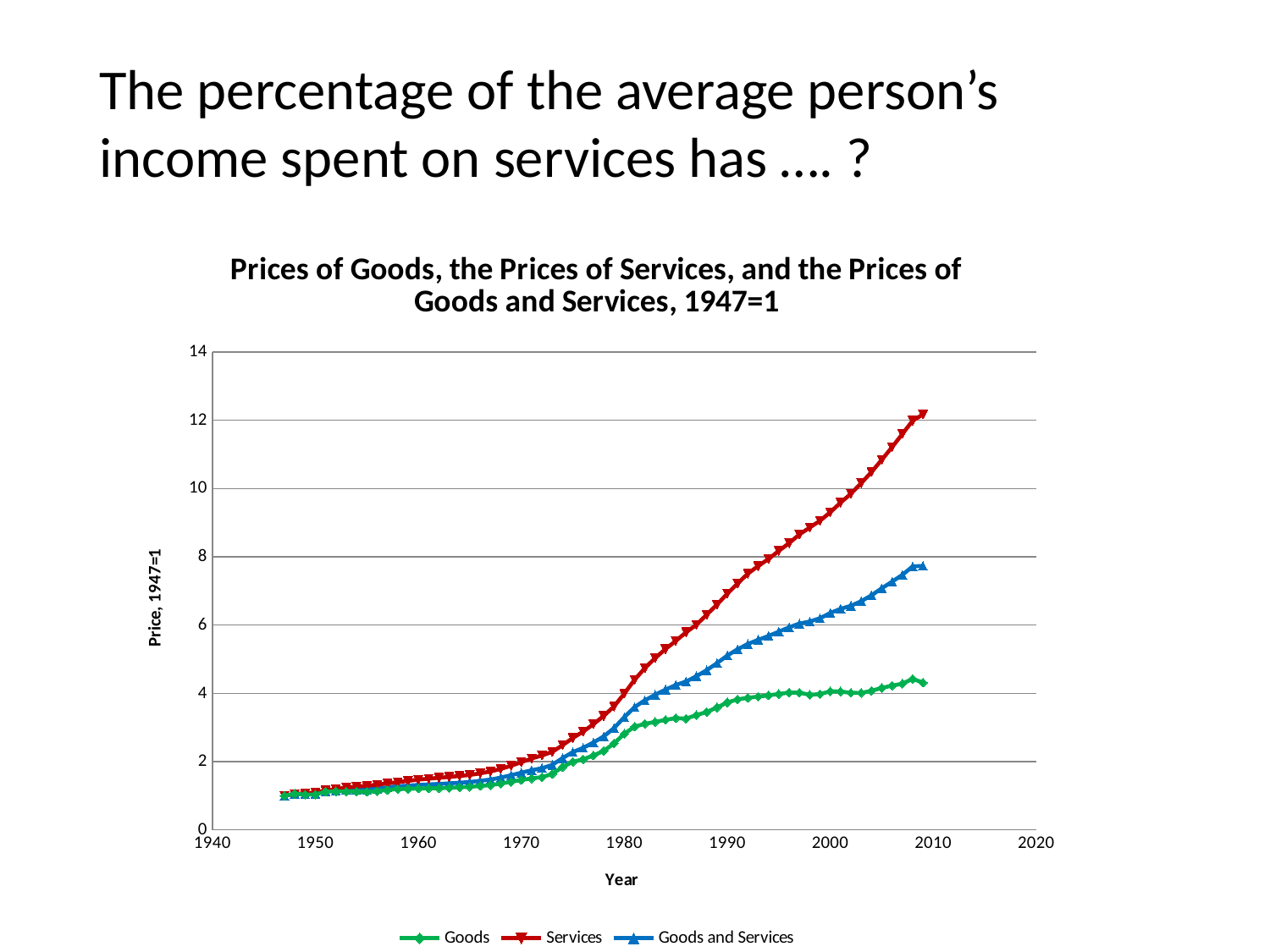
Is the value for Goods and Services in 2009 greater or less than 6? greater What are the three series listed in the legend? Goods, Services, Goods and Services Is the value for Goods in 2000 greater or less than 6? less Is the value for Services in 2000 greater or less than 8? greater Which series has the lowest value at the end of the period? Goods Does the Services series rise or fall over time along the x axis? rise Which series reaches the highest value by the end of the period? Services What kind of chart is shown on the slide? line chart How many series does the legend list? 3 In 2000, which is larger: the value for Services or the value for Goods? Services What is the label of the vertical axis? Price, 1947=1